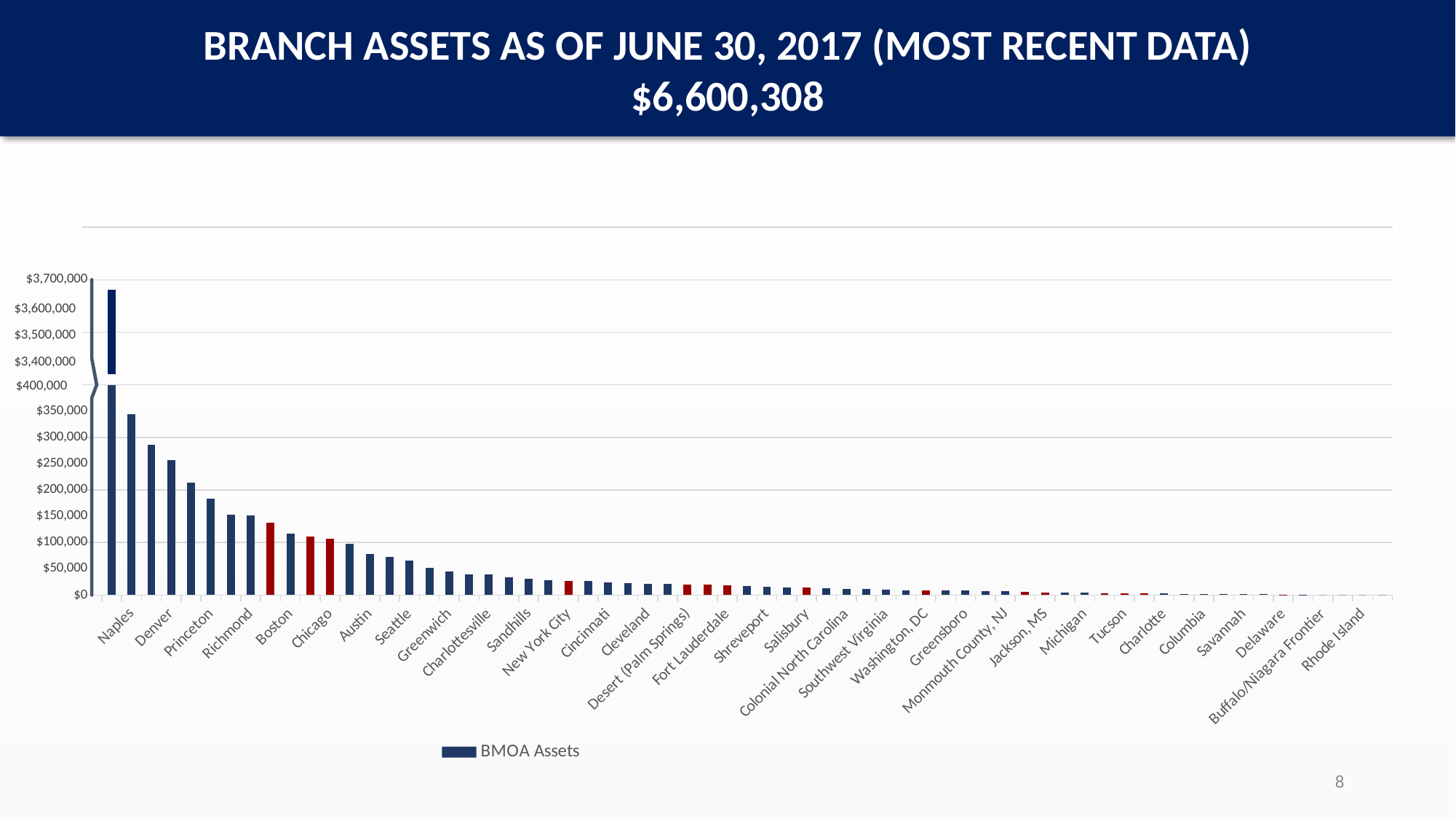
Which branch has higher assets, Boston or Seattle? Boston Is the value for Seattle greater or less than $50,000? greater What is the name of the series shown in the legend? BMOA Assets Is the value for Boston greater or less than $100,000? greater Is the value for Naples greater or less than $3,400,000? less What total asset figure is given in the chart title? $6,600,308 What kind of chart is shown on the slide? bar chart How many series does the legend list? 1 Do the branch asset values generally rise or fall moving from left to right along the x axis? fall